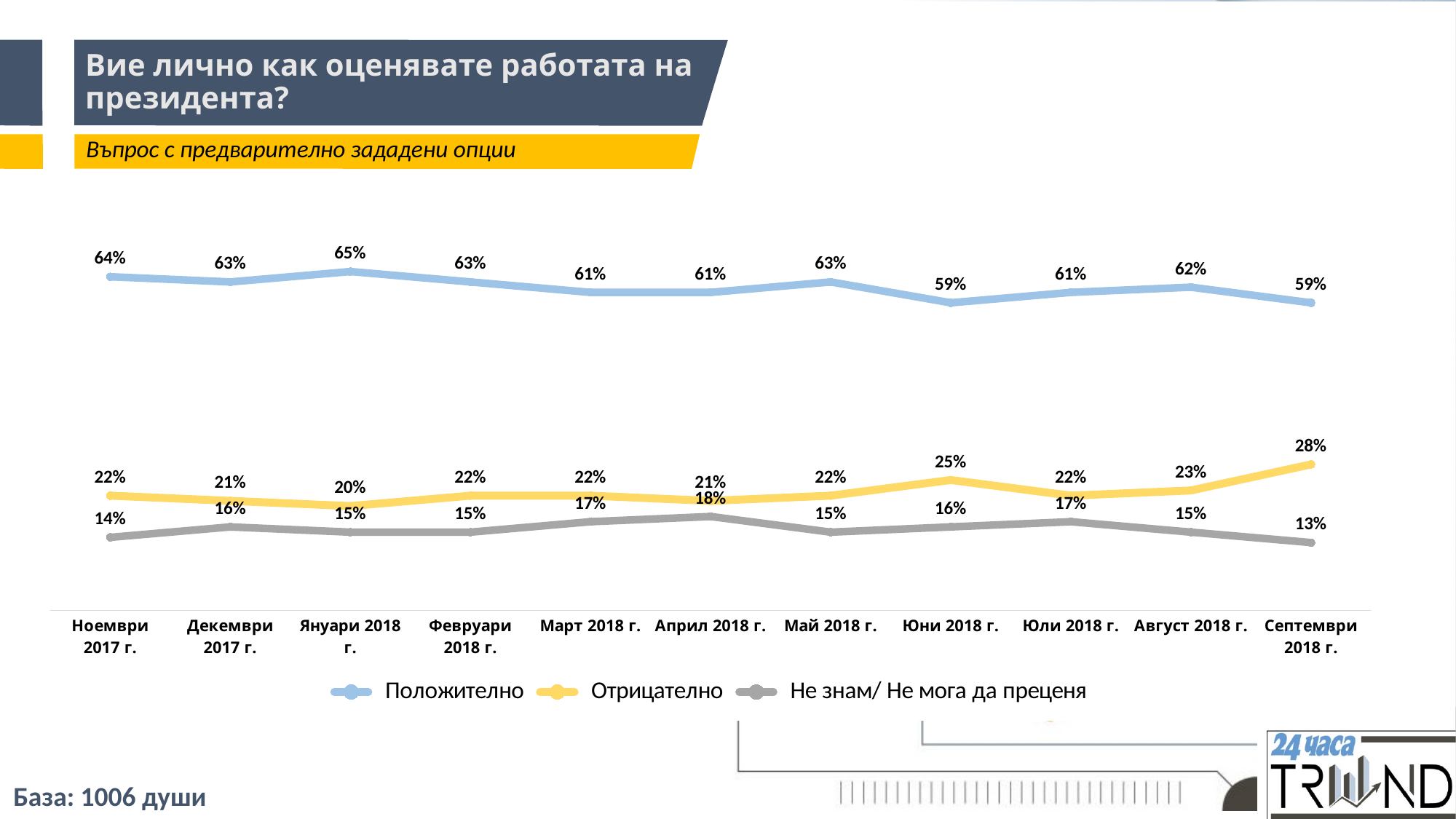
In which month is the Положително series at its highest? Януари 2018 г. How many series does the legend list? 3 How many time points are plotted along the x axis? 11 Does the Отрицателно series rise or fall between Юли 2018 г. and Септември 2018 г.? rise In which month is the Не знам/ Не мога да преценя series at its lowest? Септември 2018 г. What is the value for Отрицателно in Септември 2018 г.? 28% What colour is the line for the Положително series? blue What kind of chart is shown on the slide? line chart What is the value for Не знам/ Не мога да преценя in Април 2018 г.? 18% What is the difference between the Положително and Отрицателно values in Септември 2018 г.? 31% What is the value for Положително in Януари 2018 г.? 65% Which is larger in Юни 2018 г.: the Отрицателно value or the Не знам/ Не мога да преценя value? Отрицателно